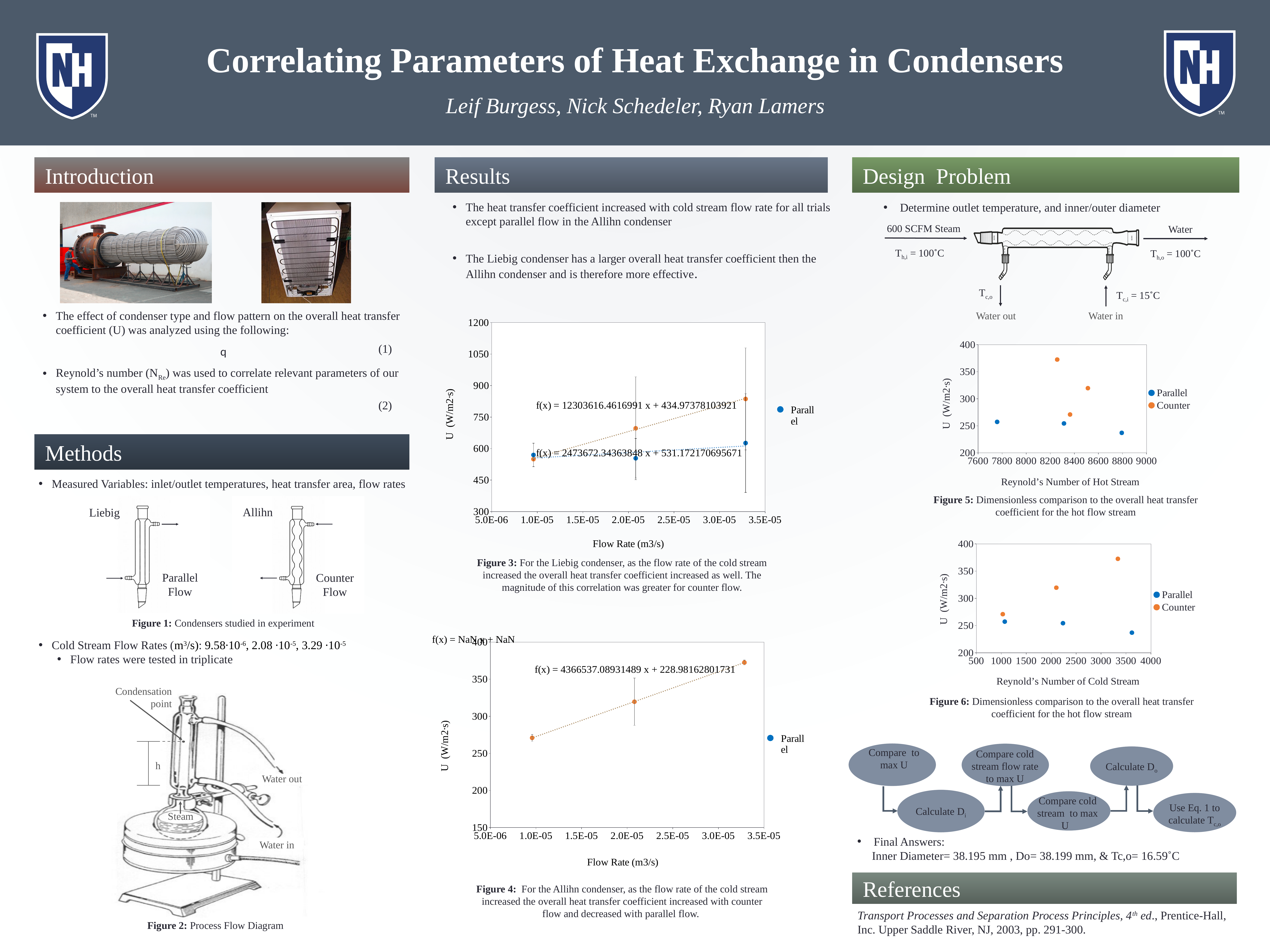
In Figure 6 (Reynold's Number of Cold Stream), how many data points are plotted in total? 6 In Figure 5 (Reynold's Number of Hot Stream), how many series does the legend list? 2 In Figure 4 (Allihn condenser), is the value at the lowest flow rate greater or less than 300? less In Figure 5 (Reynold's Number of Hot Stream), is the highest Counter value greater or less than 350? greater In Figure 6 (Reynold's Number of Cold Stream), do the Counter values rise or fall as the Reynold's number increases? Rise In Figure 6 (Reynold's Number of Cold Stream), do the Parallel values rise or fall as the Reynold's number increases? Fall In Figure 5 (Reynold's Number of Hot Stream), is the Parallel value at the highest Reynold's number greater or less than 250? less In Figure 6 (Reynold's Number of Cold Stream), what are the two legend entries? Parallel and Counter In Figure 4 (Allihn condenser), do the plotted U values rise or fall as the flow rate increases? Rise In Figure 3 (Liebig condenser), at the highest flow rate, which series has the larger U value, Parallel or Counter? Counter What kind of chart is Figure 3 (U versus Flow Rate for the Liebig condenser)? Scatter chart